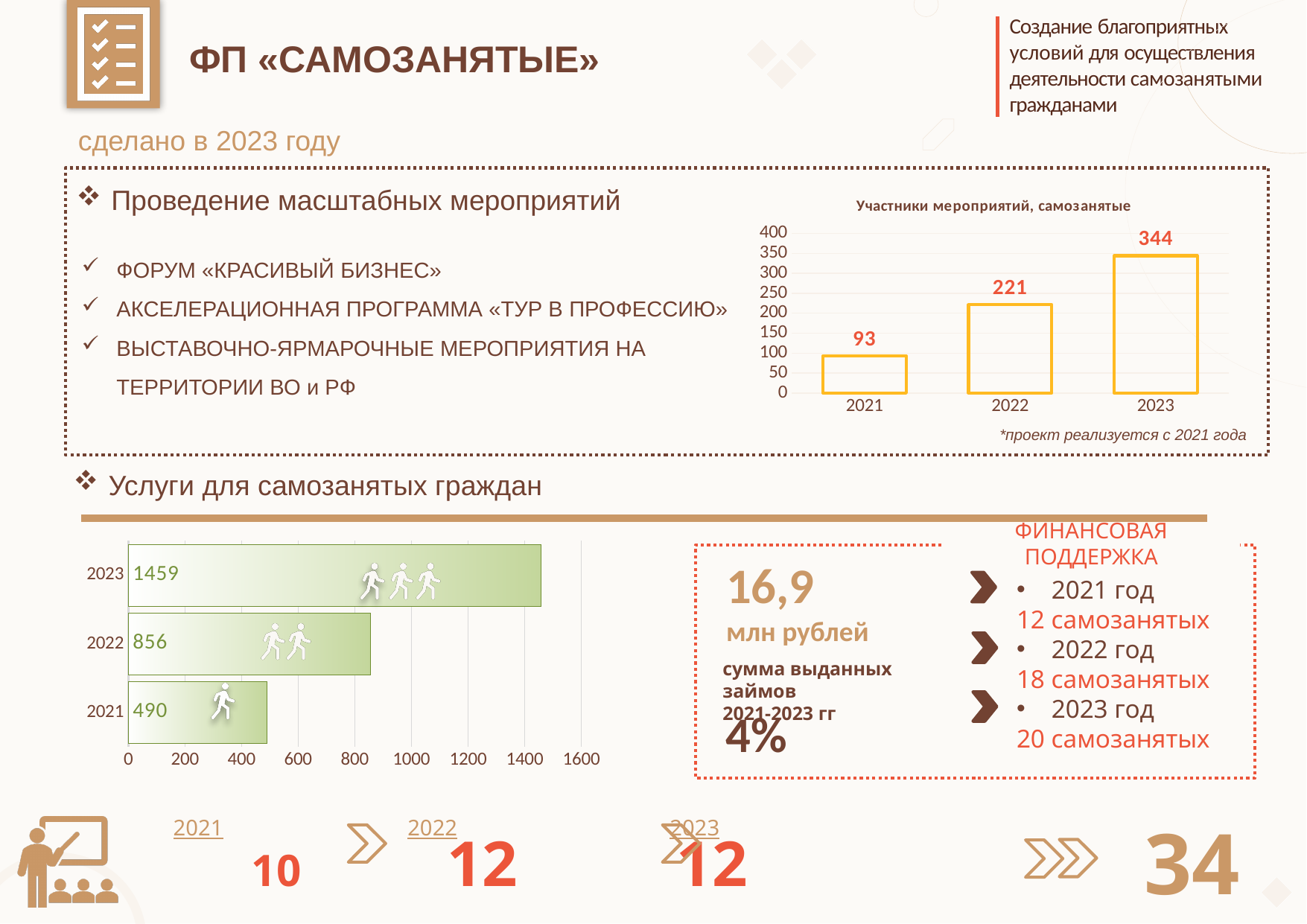
In the chart titled «Участники мероприятий, самозанятые», do the values rise or fall from 2021 to 2023? rise In the chart titled «Участники мероприятий, самозанятые», what is the value for 2023? 344 In the chart titled «Участники мероприятий, самозанятые», how many years are shown on the x axis? 3 What kind of chart is the chart titled «Участники мероприятий, самозанятые»? bar chart In the chart titled «Участники мероприятий, самозанятые», which year has the highest value? 2023 In the horizontal bar chart at the bottom left of the slide, what is the value for 2023? 1459 In the chart titled «Участники мероприятий, самозанятые», which year has the lowest value? 2021 In the chart titled «Участники мероприятий, самозанятые», what is the value for 2021? 93 In the chart titled «Участники мероприятий, самозанятые», what is the difference between the values for 2023 and 2022? 123 In the horizontal bar chart at the bottom left of the slide, what is the value for 2021? 490 In the horizontal bar chart at the bottom left of the slide, which is larger, the value for 2022 or the value for 2021? 2022 In the horizontal bar chart at the bottom left of the slide, what is the difference between the values for 2023 and 2022? 603